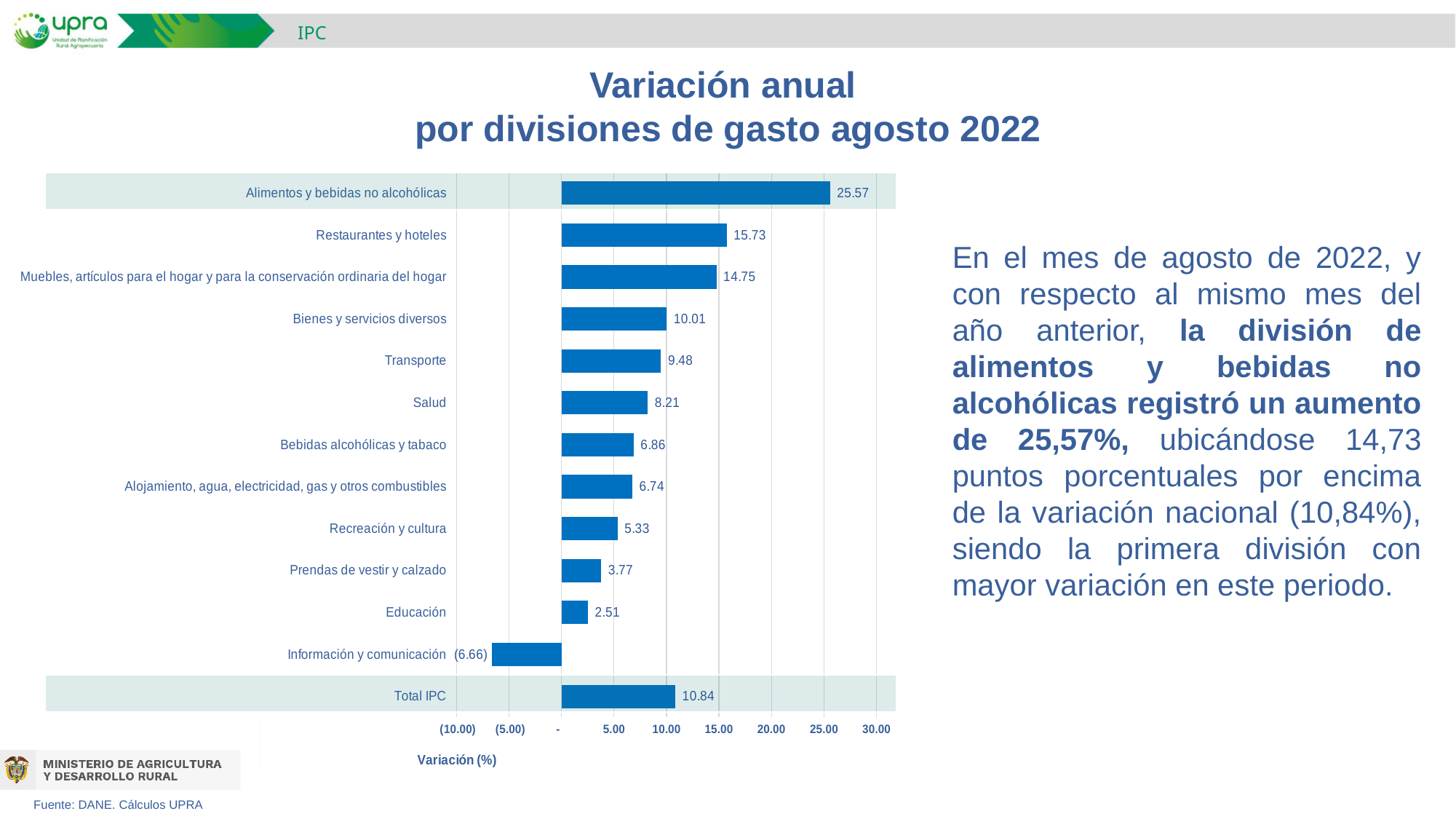
What is the value for Total IPC? 10.84 Which category has the highest value? Alimentos y bebidas no alcohólicas Is the value for Alimentos y bebidas no alcohólicas greater or less than 20.00? greater Which category has the lowest value? Información y comunicación What kind of chart is shown on the slide? bar chart How many bars are shown in the chart? 13 What is the value for Información y comunicación? (6.66) What is the difference between the value for Alimentos y bebidas no alcohólicas and the value for Total IPC? 14.73 Which is larger, the value for Transporte or the value for Salud? Transporte What is the value for Alimentos y bebidas no alcohólicas? 25.57 What is the value for Transporte? 9.48 What is the label of the horizontal axis of the chart? Variación (%)